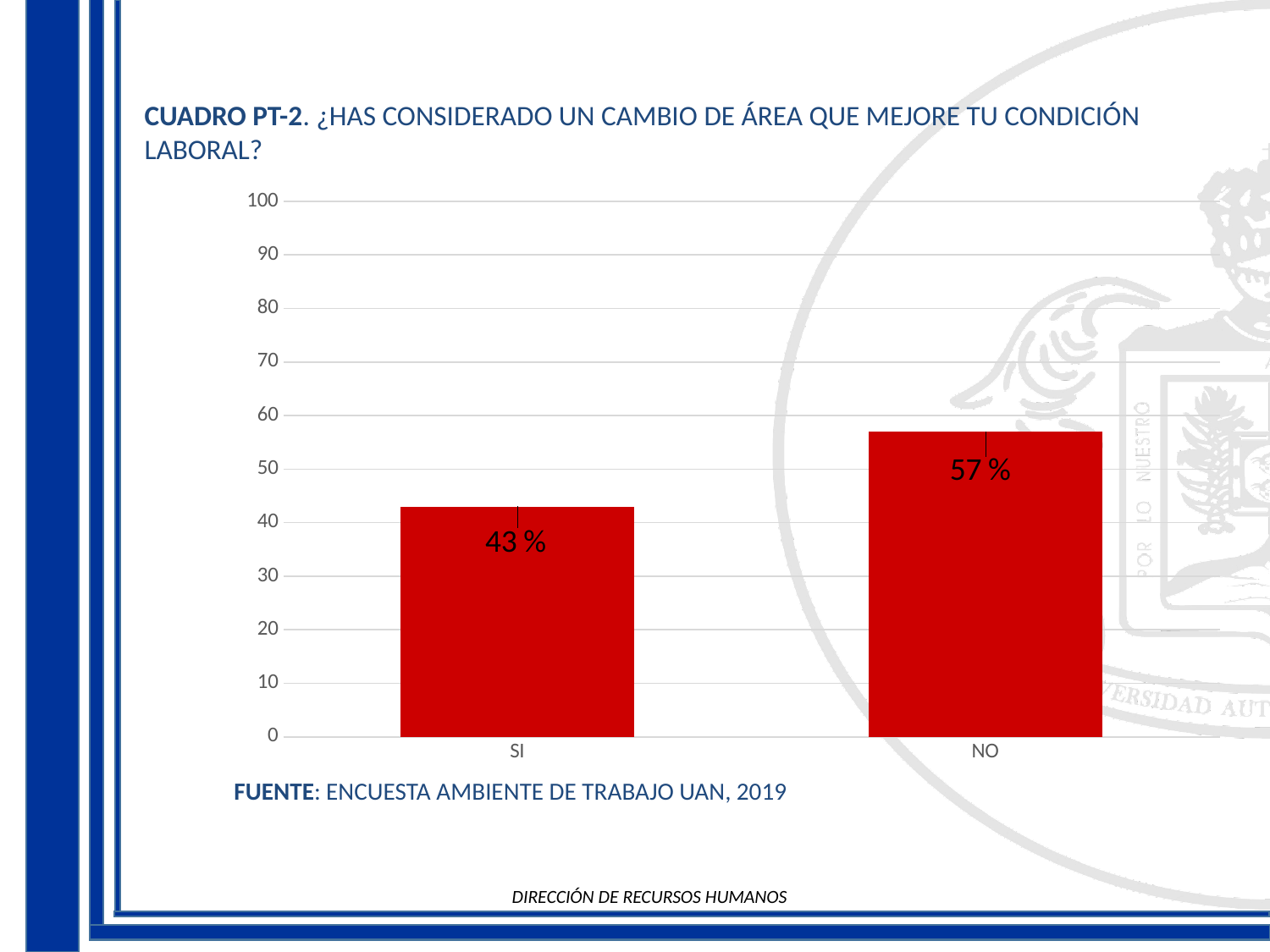
Which category has the lowest value? SI What kind of chart is shown on the slide? bar chart Which is larger, the value for SI or the value for NO? NO What colour are the bars in the chart? red What is the value for NO? 57 % What is the source cited below the chart? ENCUESTA AMBIENTE DE TRABAJO UAN, 2019 Is the value for SI greater or less than 50? less What is the value for SI? 43 % Is the value for NO greater or less than 50? greater Which category has the highest value? NO How many categories are shown on the x axis? 2 What is the difference between the values for NO and SI? 14 %